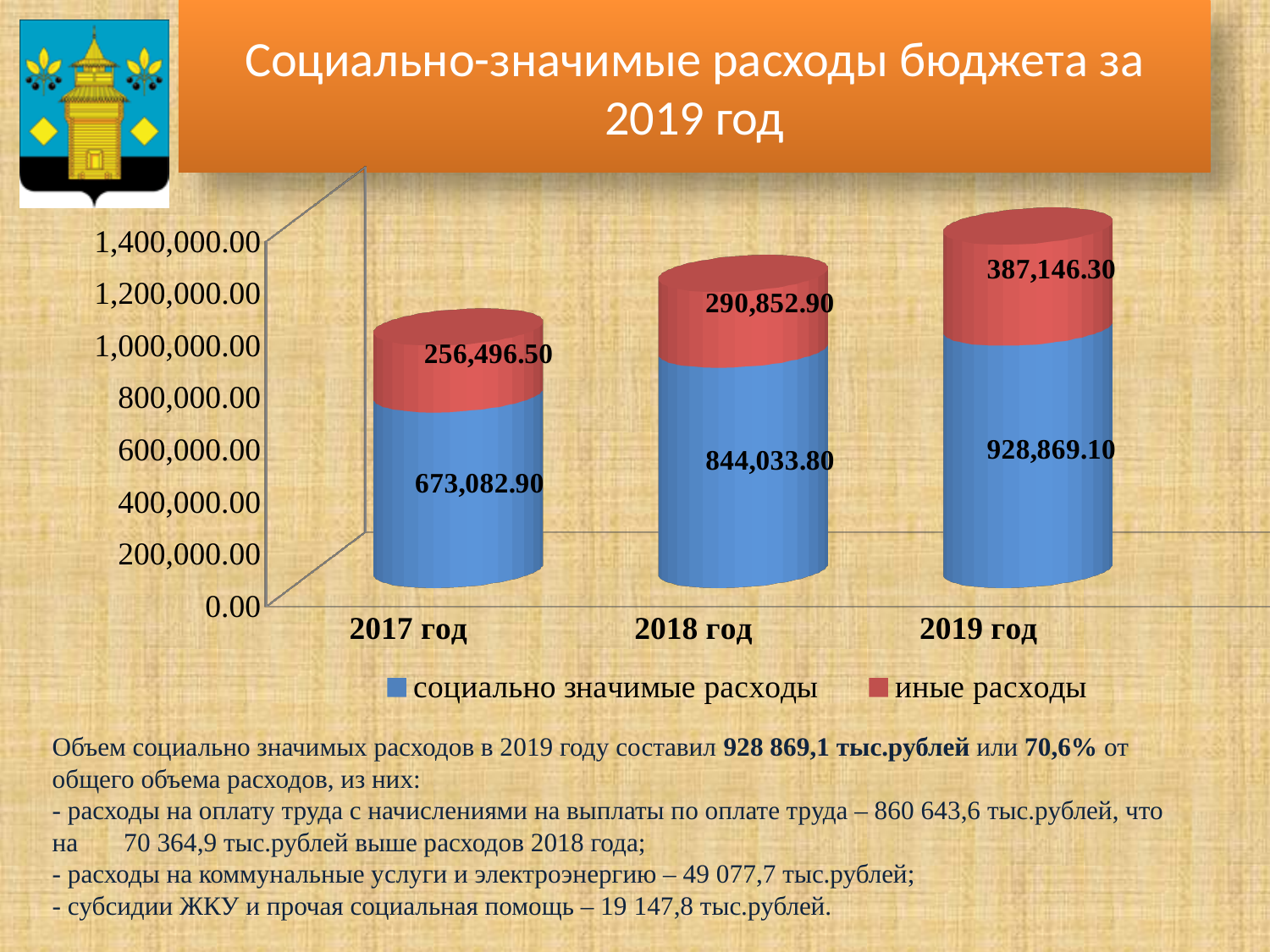
Which is larger: социально значимые расходы in 2017 год or иные расходы in 2019 год? социально значимые расходы in 2017 год Which year has the highest value of социально значимые расходы? 2019 год Which year has the lowest value of иные расходы? 2017 год By how much did социально значимые расходы increase from 2018 год to 2019 год? 84,835.30 Do the values of социально значимые расходы rise or fall from 2017 год to 2019 год? rise What is the difference between иные расходы in 2019 год and 2018 год? 96,293.40 What is the total of the stacked bar for 2017 год? 929,579.40 What is the value of иные расходы for 2017 год? 256,496.50 How many series does the legend list? 2 What is the value of социально значимые расходы for 2018 год? 844,033.80 What is the total of the stacked bar for 2019 год? 1,316,015.40 What is the value of социально значимые расходы for 2019 год? 928,869.10